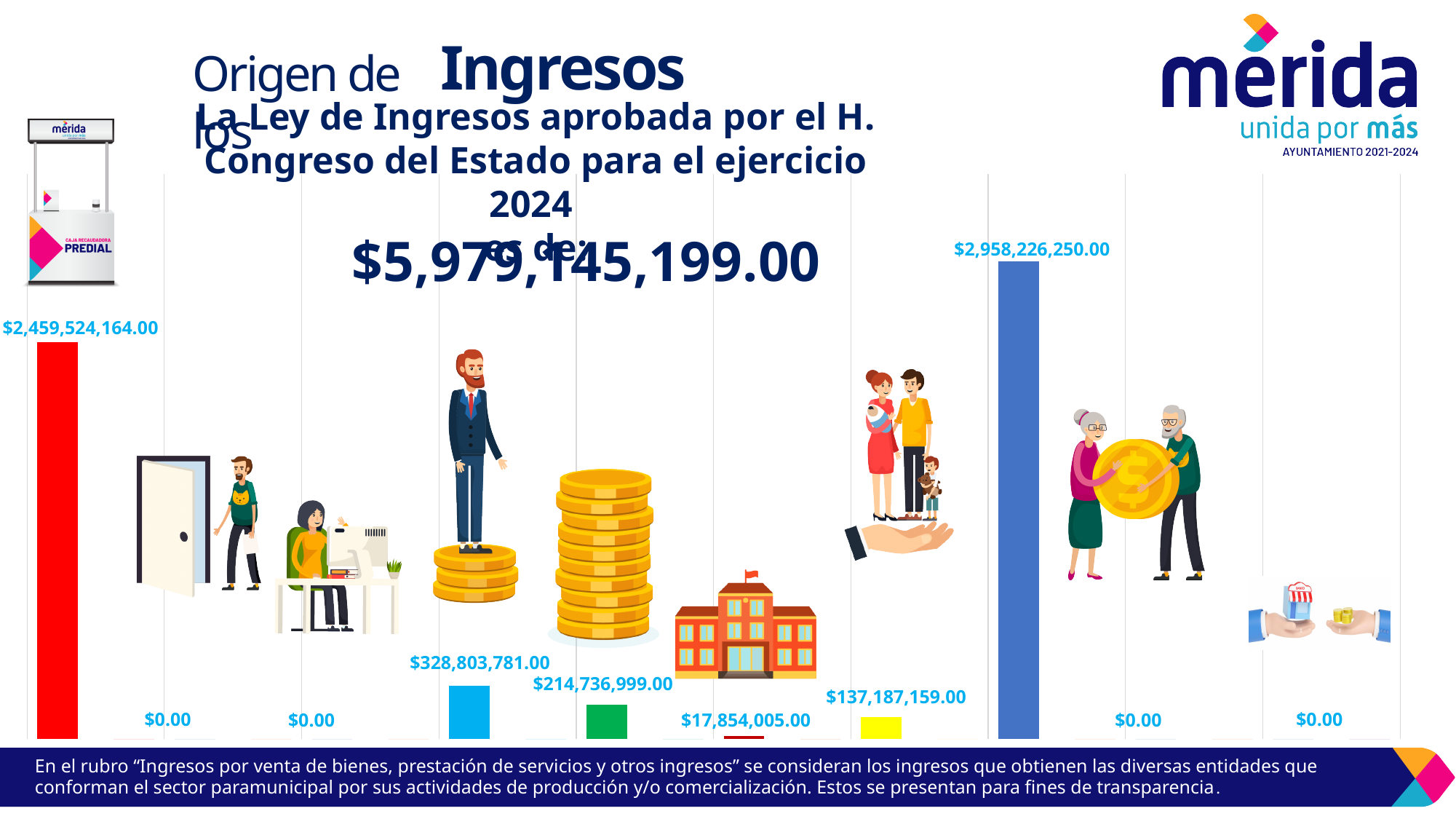
What is the difference between the tall blue bar ($2,958,226,250.00) and the leftmost red bar ($2,459,524,164.00)? $498,702,086.00 What value is labelled on the leftmost (red) bar of the chart? $2,459,524,164.00 How many bars on the chart are labelled $0.00? 4 Which is larger: the value of the tall blue bar or the value of the leftmost red bar? the tall blue bar How many bars (categories) does the chart contain? 10 What value is labelled on the green bar of the chart? $214,736,999.00 What value is labelled on the light-blue (cyan) bar of the chart? $328,803,781.00 What value is labelled on the yellow bar of the chart? $137,187,159.00 What kind of chart is shown on the slide? bar chart What value is labelled on the tall blue bar of the chart? $2,958,226,250.00 What total amount for the 2024 Ley de Ingresos is stated on the slide? $5,979,145,199.00 What is the highest value labelled on the chart? $2,958,226,250.00